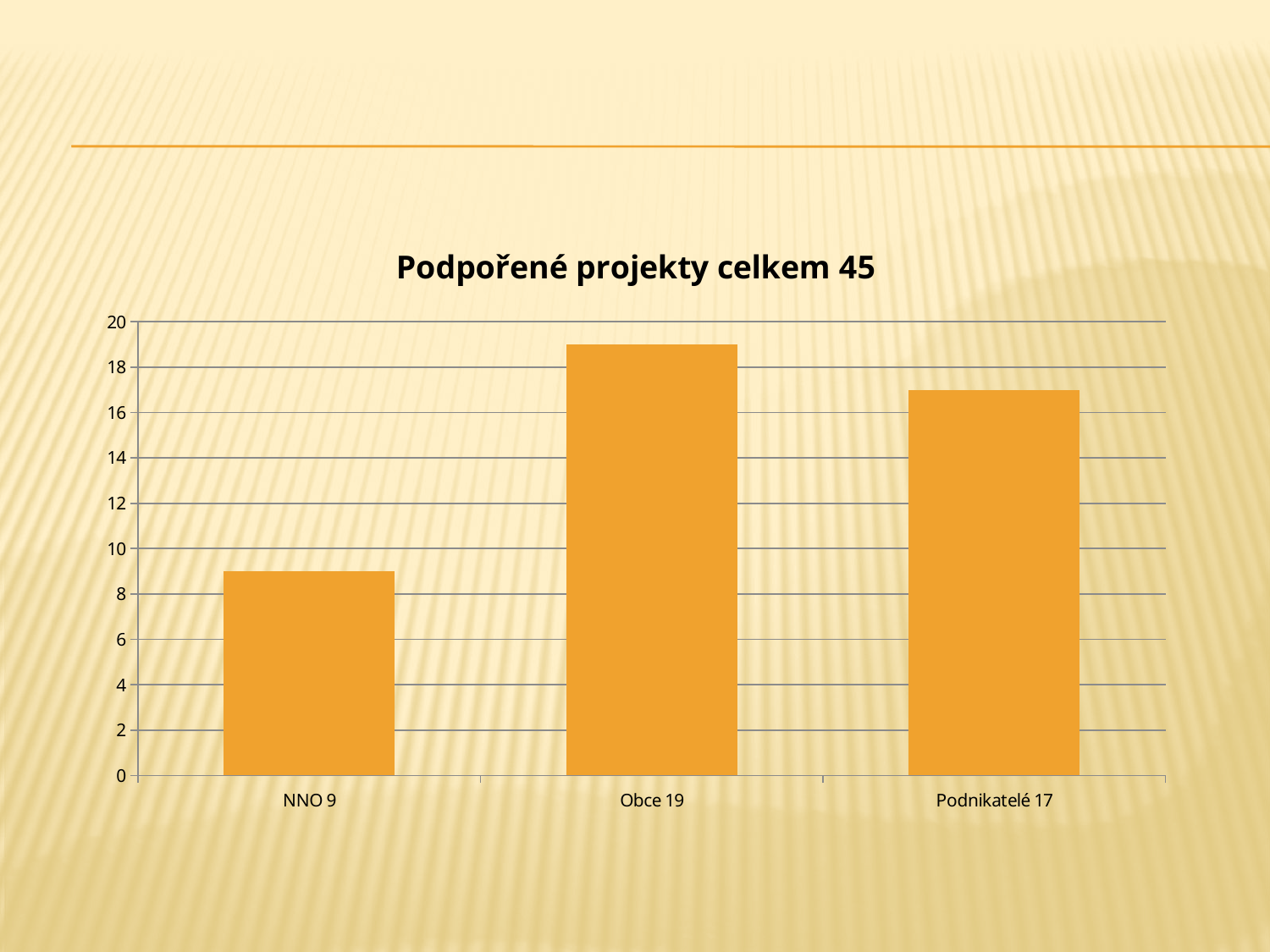
Which is larger, the value for Podnikatelé or the value for NNO? Podnikatelé What is the value for NNO? 9 What is the value for Obce? 19 What is the value for Podnikatelé? 17 What is the title of the chart? Podpořené projekty celkem 45 Which category has the highest value? Obce Is the value for NNO greater or less than 10? less What kind of chart is shown on the slide? bar chart What is the difference between the values for Obce and Podnikatelé? 2 What is the difference between the values for Obce and NNO? 10 Which category has the lowest value? NNO How many categories are shown in the chart? 3